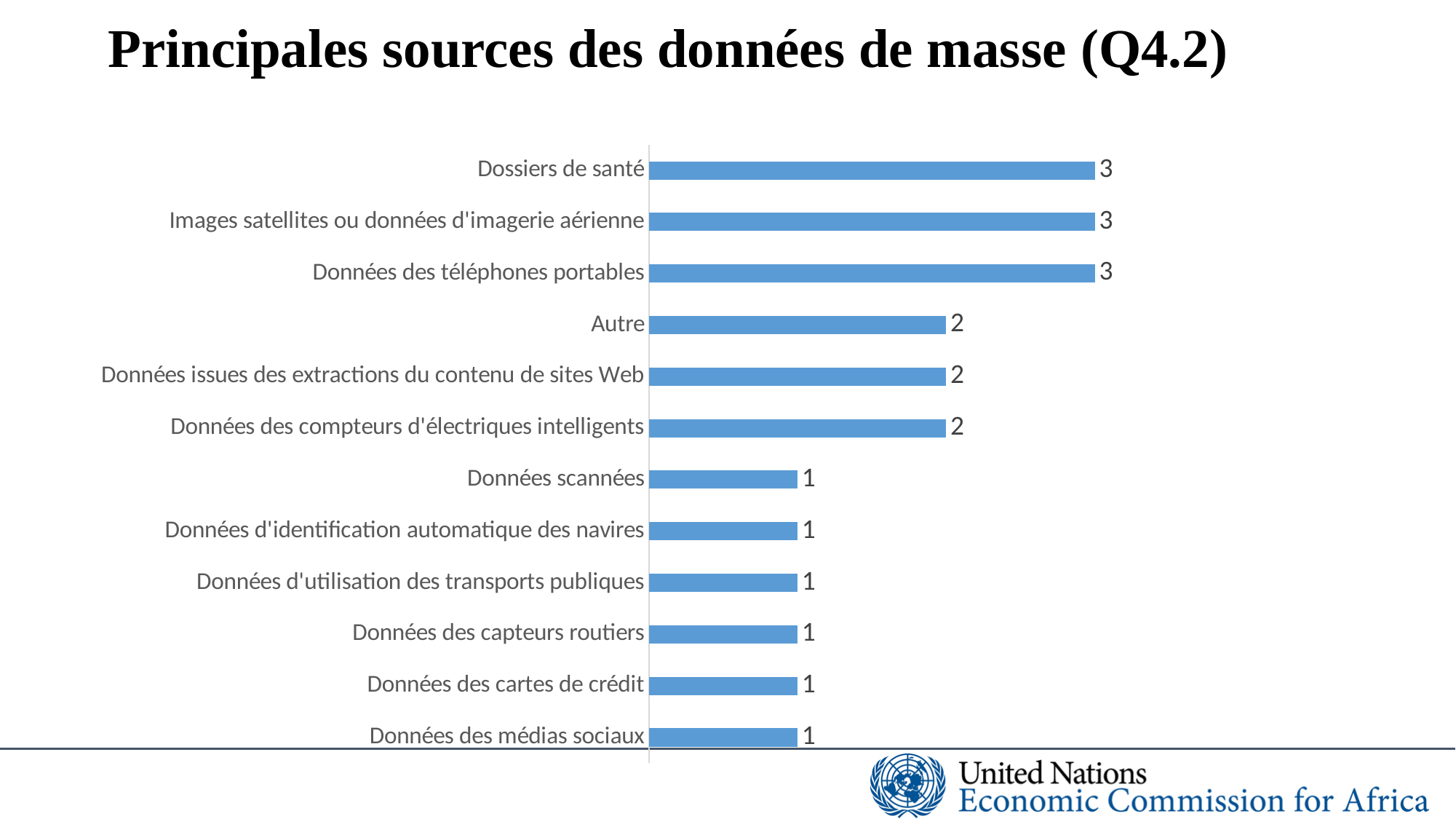
Which is larger, the value for Images satellites ou données d'imagerie aérienne or the value for Données issues des extractions du contenu de sites Web? Images satellites ou données d'imagerie aérienne What is the value for Autre? 2 How many categories are shown in the chart? 12 What is the value for Données des médias sociaux? 1 What is the title of the slide? Principales sources des données de masse (Q4.2) What kind of chart is shown on the slide? Bar chart What is the difference between the values for Données des téléphones portables and Données scannées? 2 What is the value for Données des compteurs d'électriques intelligents? 2 Which is larger, the value for Autre or the value for Données des cartes de crédit? Autre What colour are the bars in the chart? Blue What is the value for Dossiers de santé? 3 How many categories have a value of 1? 6